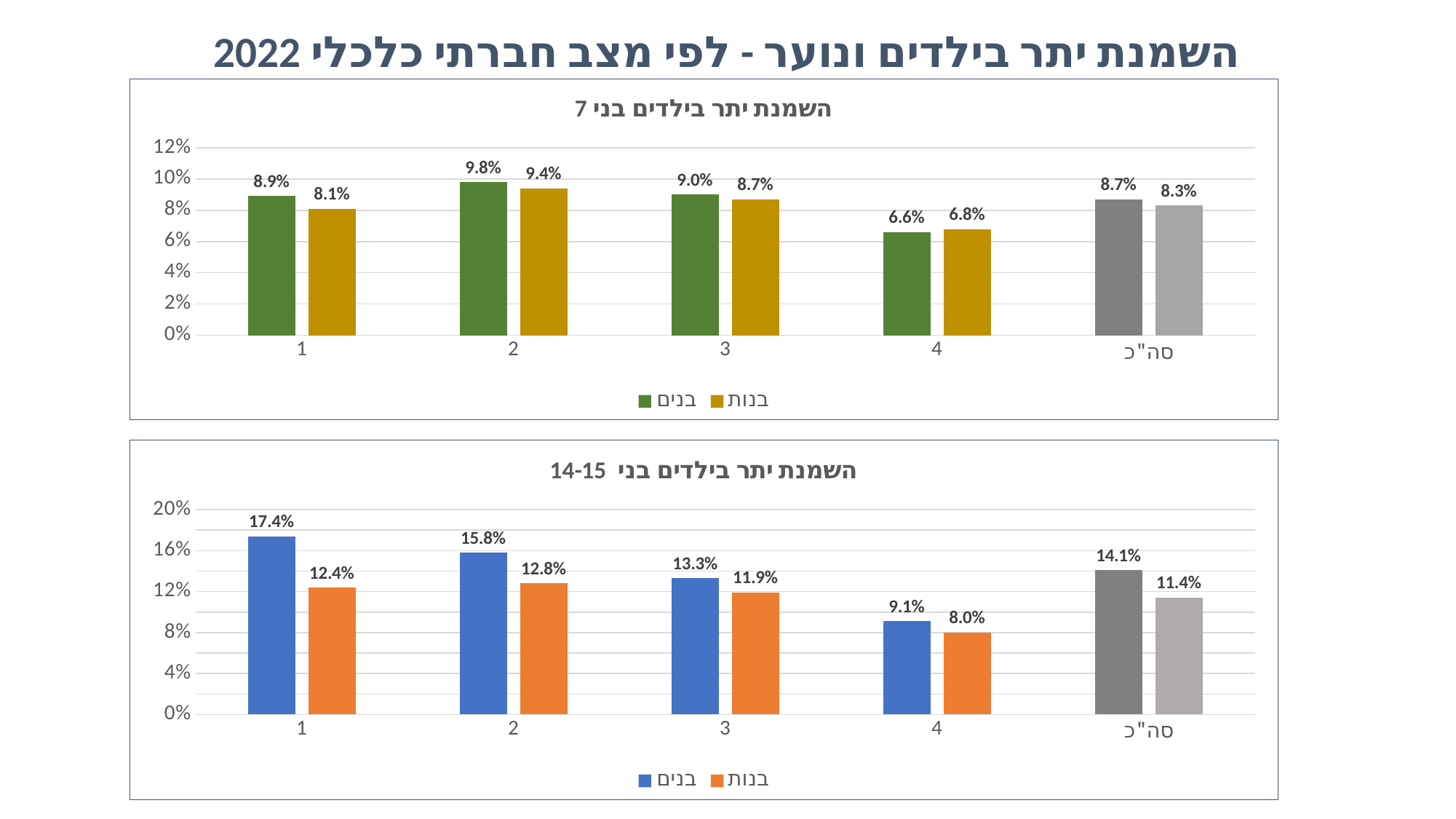
In the top chart (השמנת יתר בילדים בני 7), what is the value for בנים in category 2? 9.8% In the bottom chart (השמנת יתר בילדים בני 14-15), what is the difference between בנים and בנות in category 2? 3.0% In the bottom chart (השמנת יתר בילדים בני 14-15), do the values for בנים rise or fall from category 1 to category 4? fall In the bottom chart (השמנת יתר בילדים בני 14-15), what is the value for בנות in the סה"כ category? 11.4% In the top chart (השמנת יתר בילדים בני 7), what is the difference between בנים and בנות in category 1? 0.8% What kind of chart is the top chart (השמנת יתר בילדים בני 7)? bar chart In the top chart (השמנת יתר בילדים בני 7), what is the value for בנות in category 4? 6.8% In the top chart (השמנת יתר בילדים בני 7), how many series does the legend list? 2 In the bottom chart (השמנת יתר בילדים בני 14-15), which category has the lowest value for בנות? 4 In the bottom chart (השמנת יתר בילדים בני 14-15), what is the value for בנים in category 1? 17.4% In the top chart (השמנת יתר בילדים בני 7), which category has the highest value for בנים? 2 In the bottom chart (השמנת יתר בילדים בני 14-15), which is larger in category 3: בנים or בנות? בנים